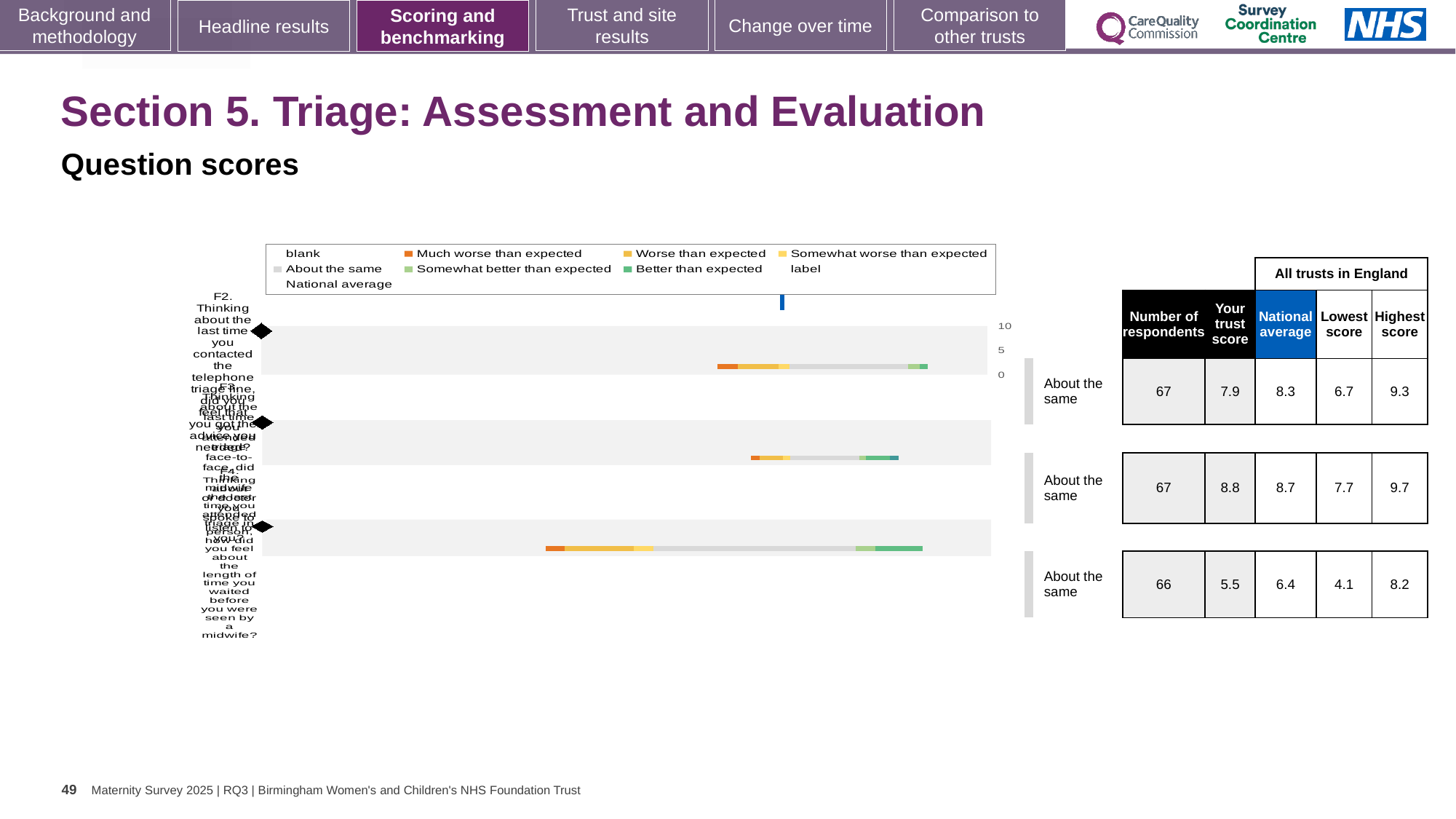
In the table, what is the highest score for the second row? 9.7 In the table, what is the number of respondents for the third row? 66 For the second row, which is larger: the trust score or the national average? the trust score (8.8) What kind of chart is shown on the slide? bar chart What is the difference between the highest score and the lowest score for the first row (F2)? 2.6 What is the highest value shown on the chart's axis? 10 In the table, what is the 'Your trust score' for the first row (F2, telephone triage line)? 7.9 Which row has the highest 'Your trust score' in the table? the second row (8.8) How many entries does the chart legend list? 9 Which row has the lowest 'Your trust score' in the table? the third row (5.5) How many question rows (categories) does the chart show? 3 In the table, what is the national average for the first row (F2)? 8.3